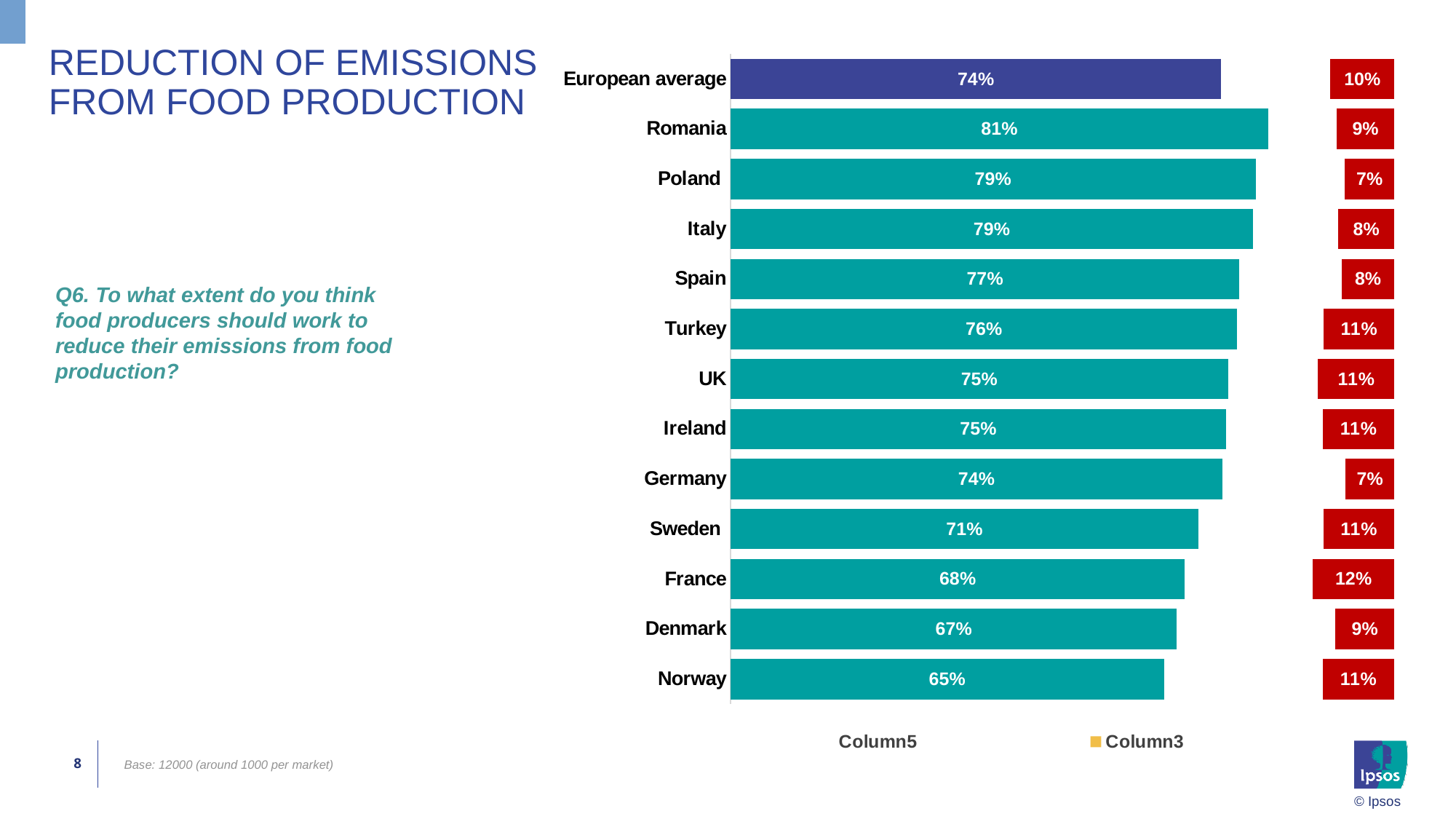
How many categories (bars) are shown in the chart? 13 What is the value of the bar for European average? 74% What is the value of the bar for Norway? 65% What is the value shown in the red box for France? 12% Which has a larger bar value, Poland or Turkey? Poland What is the value of the bar for Romania? 81% What is the difference between the bar values for Romania and Norway? 16% What type of chart is shown on the slide? Bar chart Which country has the lowest bar value? Norway What is the difference between the bar values for Spain and Sweden? 6% Which country has the highest bar value? Romania How many entries does the legend list? 2